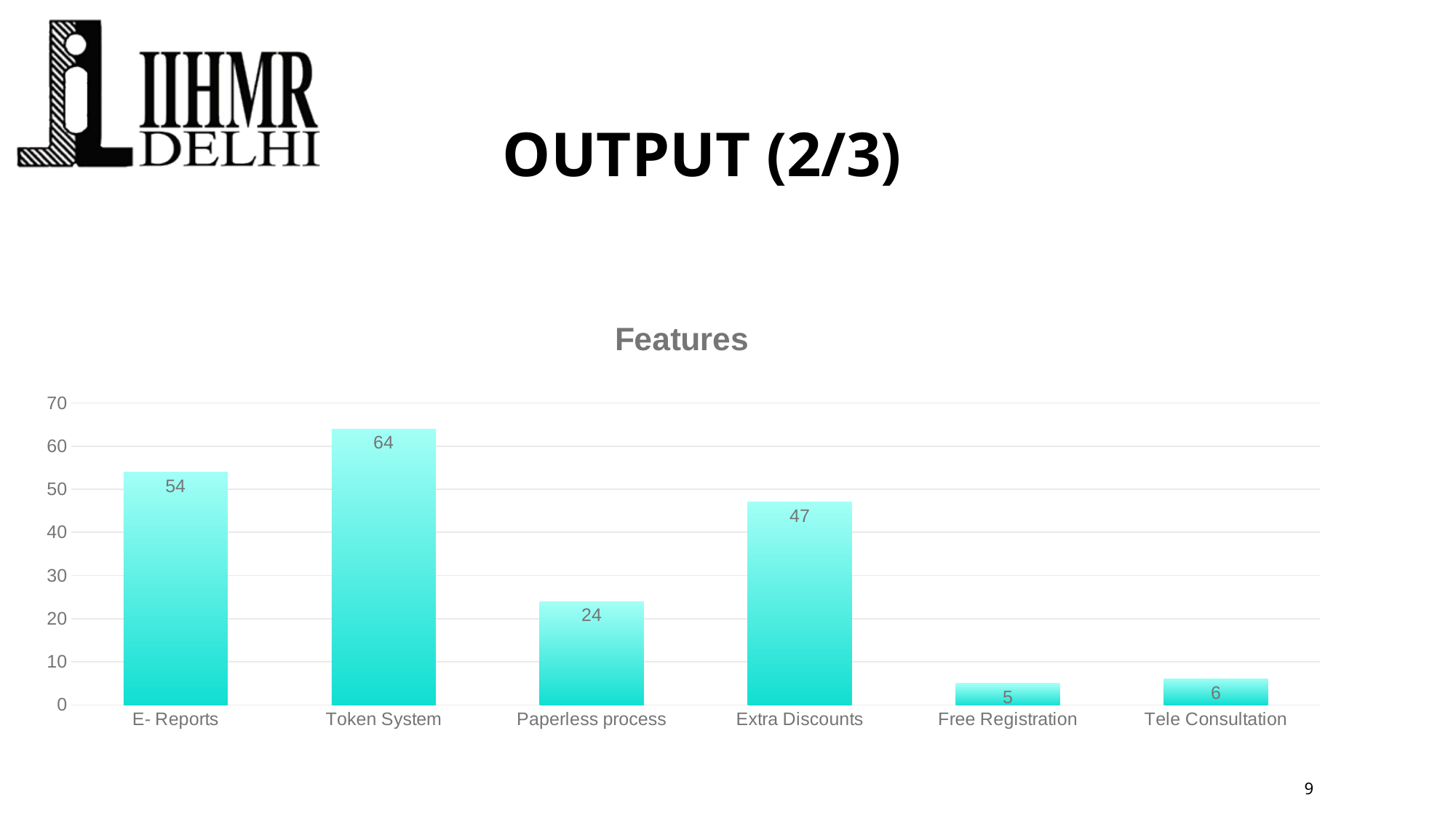
What is the title of the chart? Features Is the value for Extra Discounts greater or less than 40? greater What is the value for Free Registration? 5 What is the difference between the values for Token System and E- Reports? 10 What is the value for Token System? 64 Which category has the lowest value? Free Registration Which category has the highest value? Token System What is the value for Paperless process? 24 What kind of chart is shown on the slide? bar chart How many categories are shown on the chart? 6 What is the difference between the values for Extra Discounts and Paperless process? 23 Which is larger, the value for E- Reports or the value for Extra Discounts? E- Reports